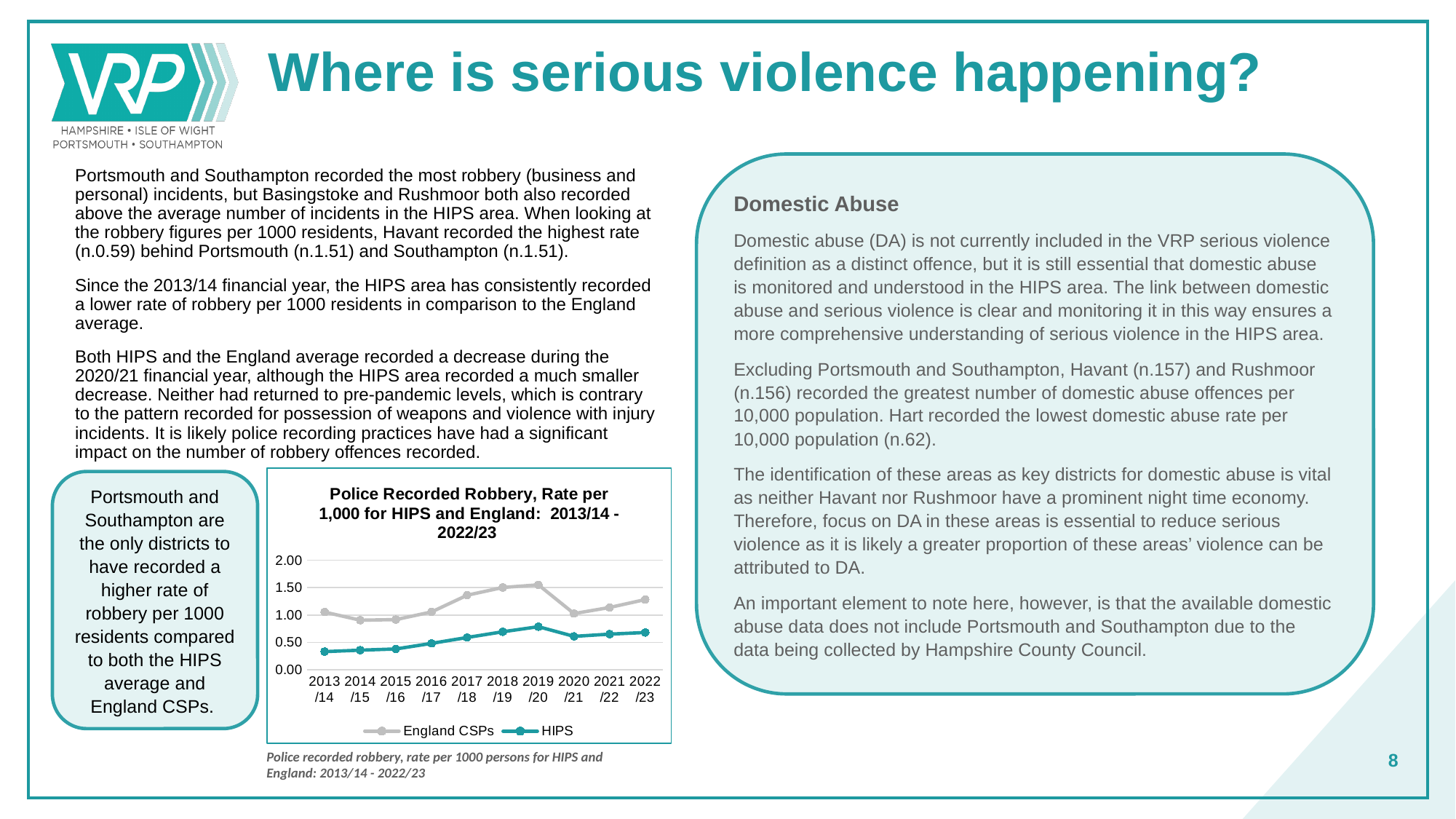
How many financial years are plotted along the x axis of the chart? 10 Is the value for HIPS in 2013/14 greater or less than 0.50? less In which year does the HIPS series reach its highest value? 2019/20 Is the value for England CSPs in 2019/20 greater or less than 1.00? greater In which year is the HIPS series at its lowest value? 2013/14 In which year does the England CSPs series reach its highest value? 2019/20 What is the title of the chart? Police Recorded Robbery, Rate per 1,000 for HIPS and England: 2013/14 - 2022/23 Which series is shown in the chart legend alongside HIPS? England CSPs Does the HIPS series rise or fall between 2013/14 and 2019/20? Rise How many series does the chart legend list? 2 What kind of chart is shown on the slide? Line chart Which series has the higher value in 2018/19, England CSPs or HIPS? England CSPs